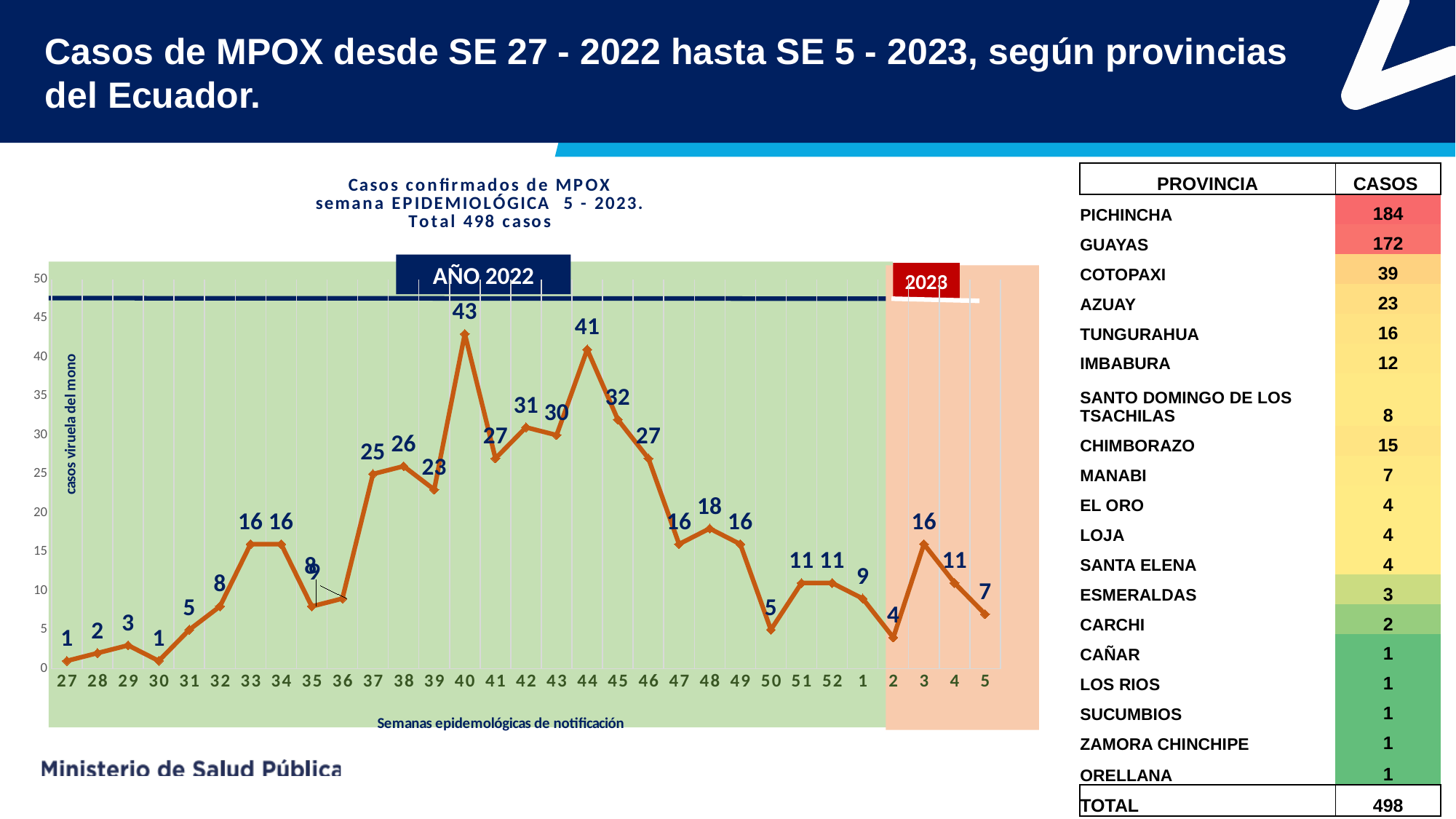
What is the difference between the cases in week 40 and week 44? 2 In which epidemiological week does the line chart reach its highest number of cases? Week 40 Which has more cases, week 42 or week 43? Week 42 What is the difference between the cases in week 48 and week 50? 13 What is the highest value plotted on the line chart? 43 What is the label on the vertical axis of the line chart? casos viruela del mono What kind of chart is used to show the cases by epidemiological week? Line chart How many epidemiological weeks are plotted on the x axis of the line chart? 31 How many cases are plotted for epidemiological week 44? 41 How many cases are plotted for week 3 of 2023? 16 Do the plotted cases rise or fall from week 44 to week 50? Fall How many cases are plotted for epidemiological week 27? 1